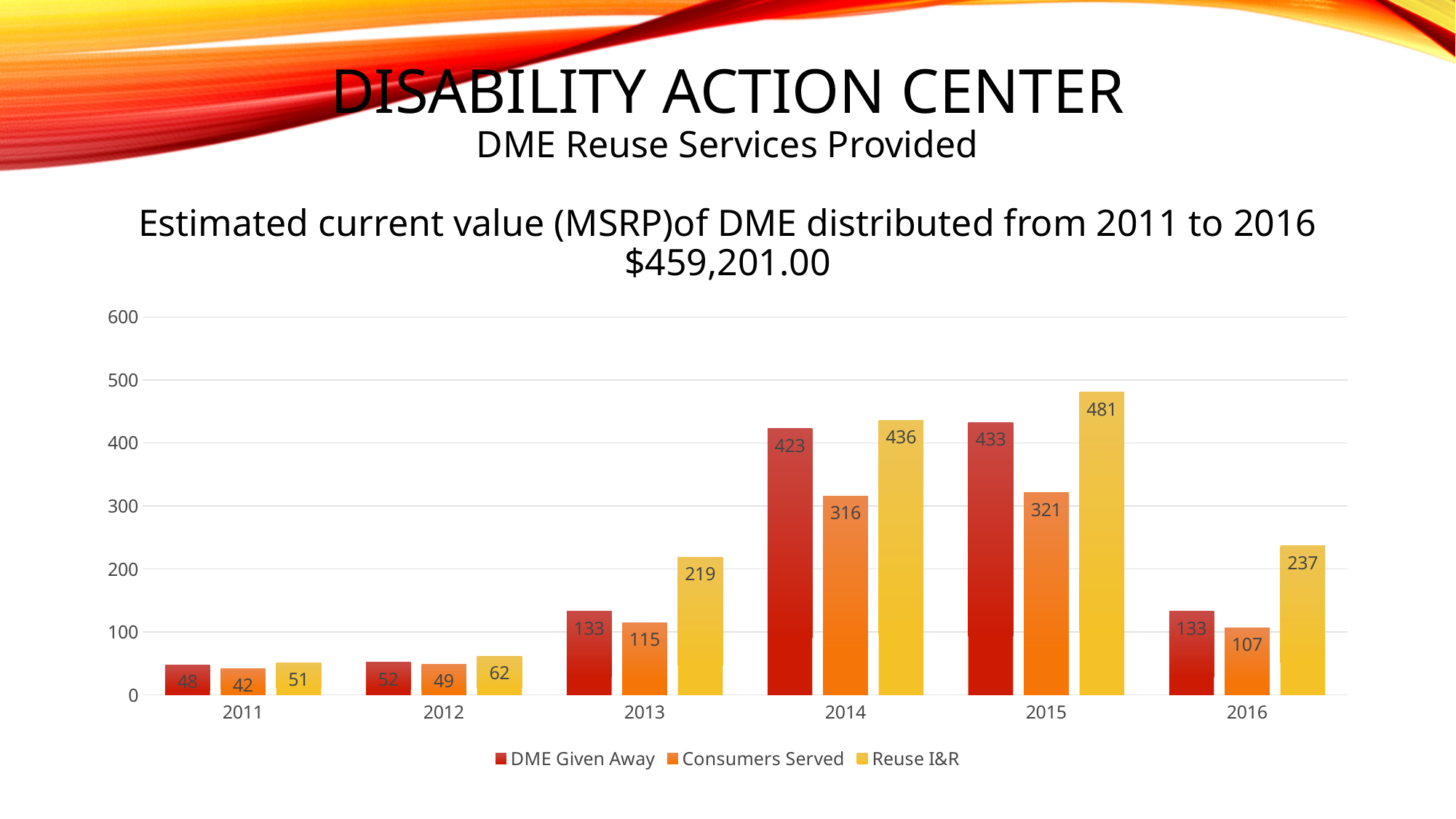
How many years are shown on the x axis? 6 Is the value for DME Given Away in 2015 greater or less than 400? greater What kind of chart is shown on the slide? Bar chart In which year is Consumers Served lowest? 2011 Does DME Given Away rise or fall from 2015 to 2016? Fall What is the value for Consumers Served in 2016? 107 What is the value for DME Given Away in 2014? 423 Which is larger in 2012: DME Given Away or Reuse I&R? Reuse I&R In which year is Reuse I&R highest? 2015 What is the value for Reuse I&R in 2013? 219 How many series does the legend list? 3 What is the difference between Reuse I&R and Consumers Served in 2015? 160